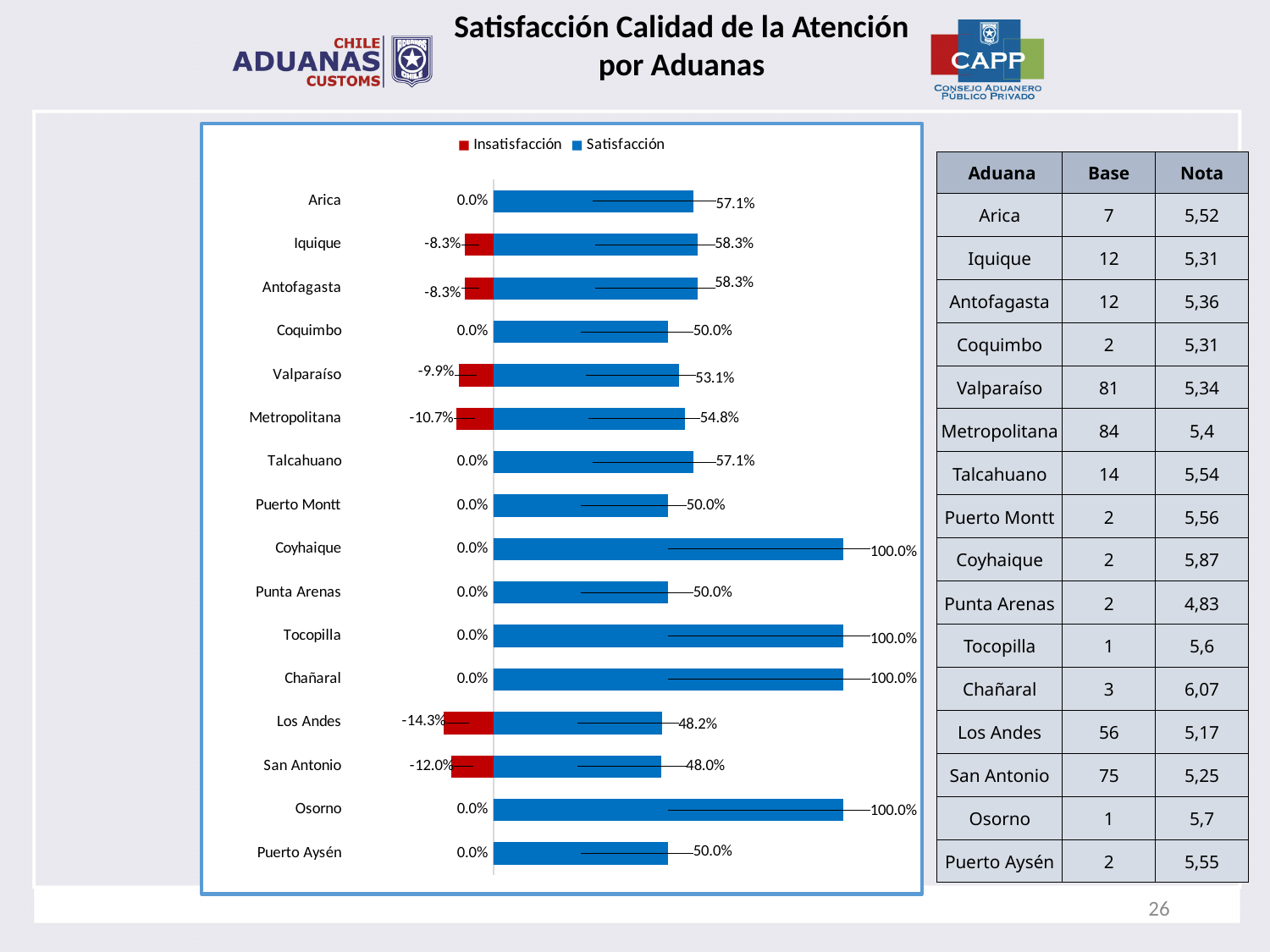
What is the Satisfacción value for Metropolitana? 54.8% What is the Insatisfacción value for San Antonio? -12.0% What kind of chart is shown on the slide? Bar chart How many series does the chart legend list? 2 Which aduana has the largest Insatisfacción (most negative value)? Los Andes How many aduanas (categories) are plotted in the chart? 16 What is the Insatisfacción value for Valparaíso? -9.9% What is the difference between the Satisfacción values for Iquique and Coquimbo? 8.3 percentage points Which has a higher Satisfacción value, Arica or Valparaíso? Arica How many aduanas have a Satisfacción value of 100.0%? 4 What are the two entries in the chart legend? Insatisfacción and Satisfacción What is the Satisfacción value for Los Andes? 48.2%